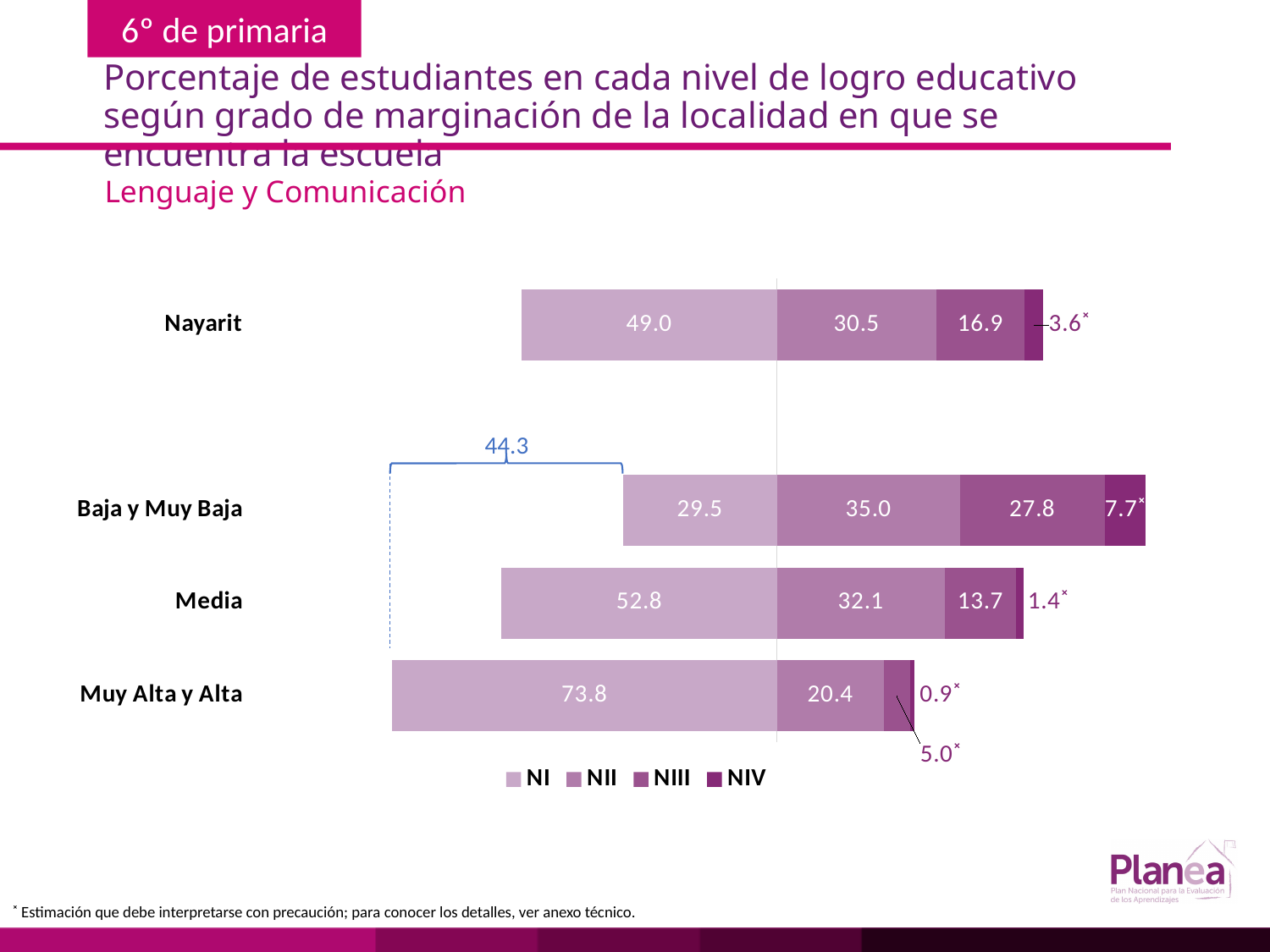
How many series does the legend list? 4 Which category has the highest NI value? Muy Alta y Alta What is the NI value for Muy Alta y Alta? 73.8 What is the difference between the NII value for Nayarit and the NII value for Muy Alta y Alta? 10.1 What is the NIII value for Nayarit? 16.9 Which is larger, the NIII value for Baja y Muy Baja or the NIII value for Media? Baja y Muy Baja How many categories are shown on the chart? 4 What is the difference between the NI value for Muy Alta y Alta and the NI value for Baja y Muy Baja? 44.3 Which category has the lowest NIV value? Muy Alta y Alta What is the NII value for Baja y Muy Baja? 35.0 What is the NIV value for Media? 1.4 What kind of chart is shown on the slide? Stacked bar chart